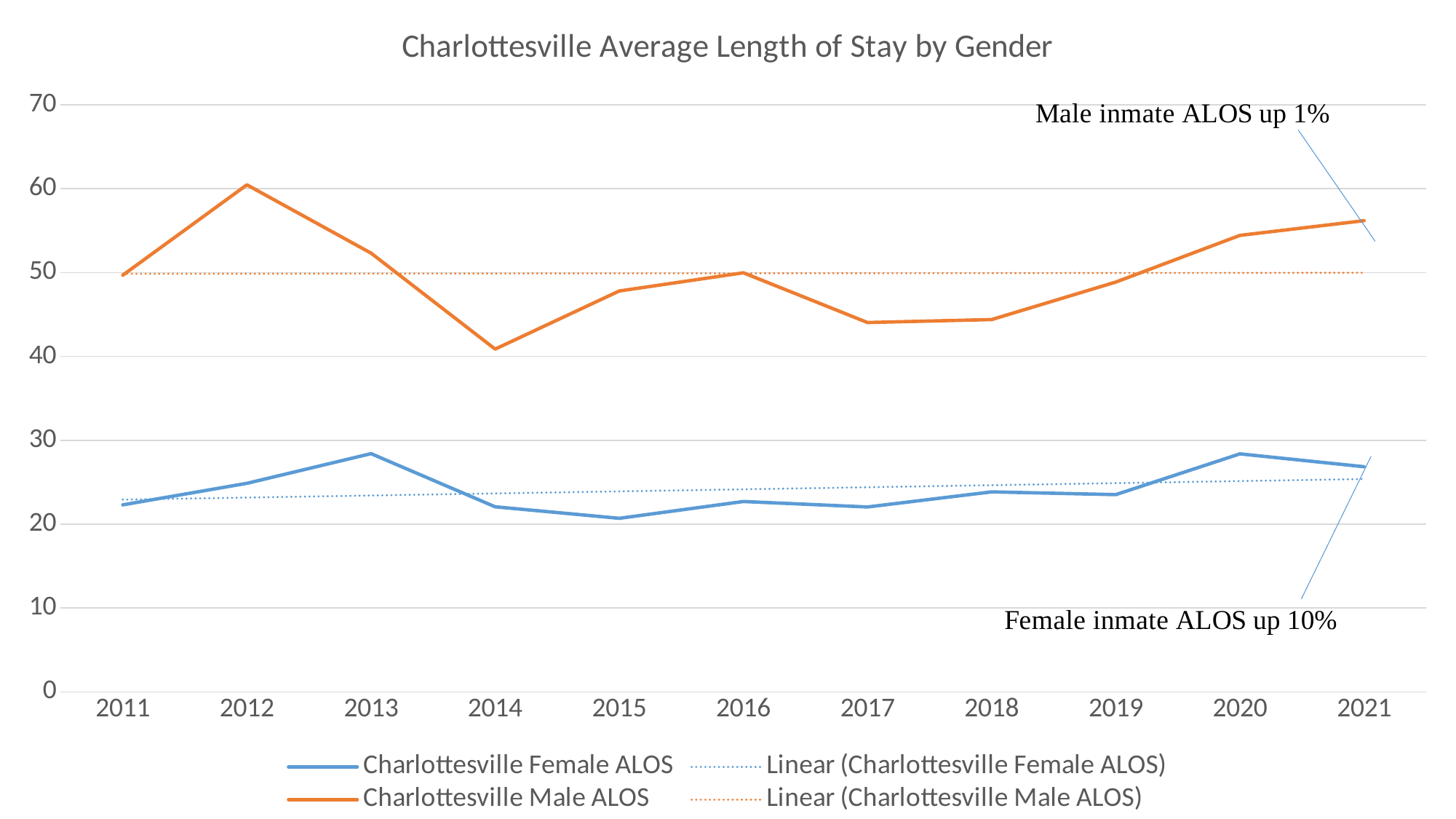
Is the Charlottesville Female ALOS in 2013 greater or less than 30? less What type of chart is shown on the slide? Line chart How many entries does the chart legend list? 4 According to the annotation on the chart, by what percentage is the female inmate ALOS up? 10% In which year is the Charlottesville Male ALOS highest? 2012 Does the Charlottesville Male ALOS rise or fall from 2018 to 2021? Rise In which year is the Charlottesville Female ALOS lowest? 2015 What is the title of the chart? Charlottesville Average Length of Stay by Gender How many years are shown on the x axis of the chart? 11 In which year is the Charlottesville Male ALOS lowest? 2014 Which is larger in 2021, the Charlottesville Male ALOS or the Charlottesville Female ALOS? Charlottesville Male ALOS